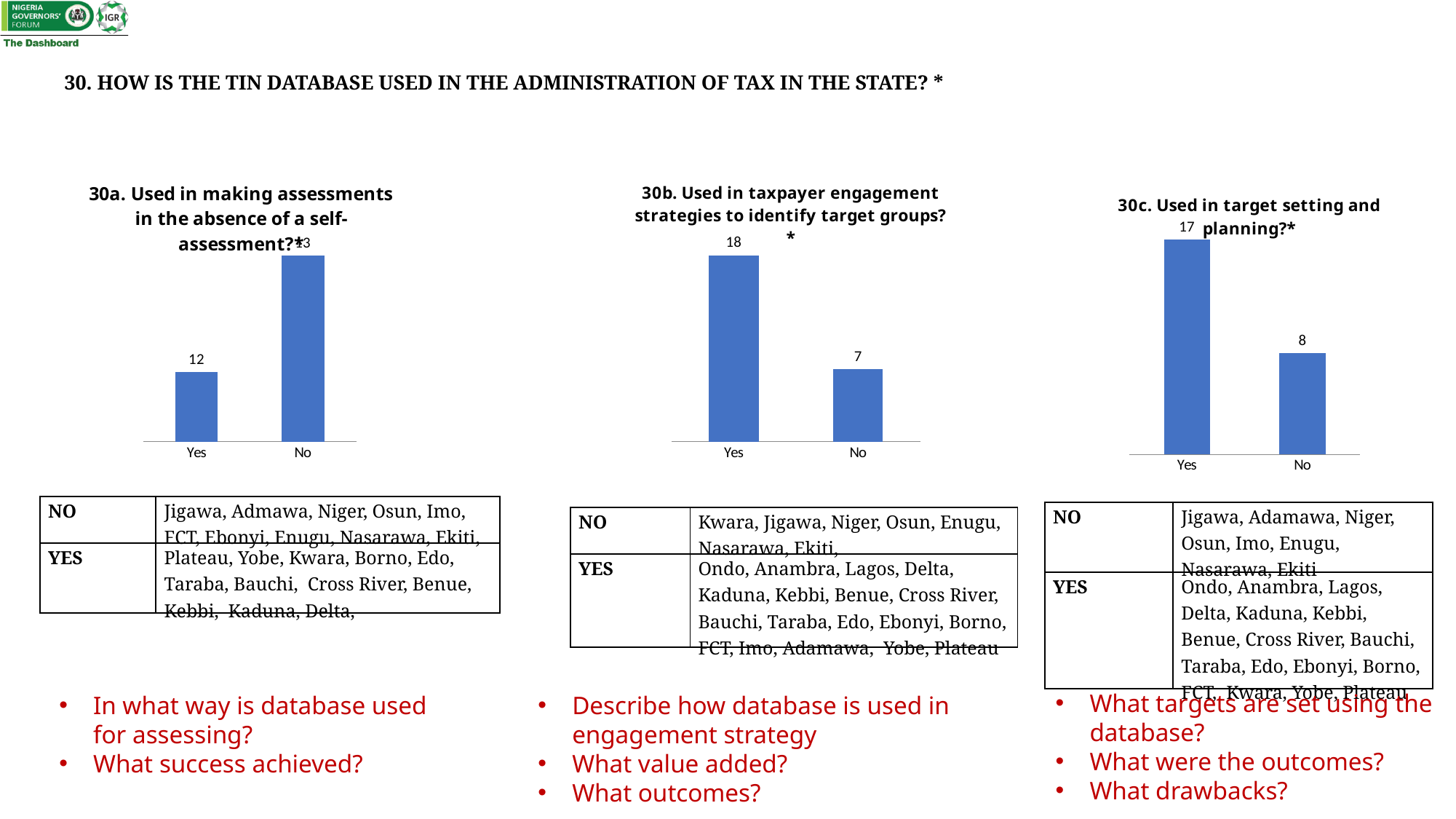
What type of chart is '30b. Used in taxpayer engagement strategies to identify target groups?'? Bar chart In the chart '30c. Used in target setting and planning?', what is the value for Yes? 17 In the chart '30a. Used in making assessments in the absence of a self-assessment?', what is the value for Yes? 12 In the chart '30c. Used in target setting and planning?', what is the difference between the Yes and No values? 9 In the chart '30c. Used in target setting and planning?', which category has the highest value? Yes In the chart '30a. Used in making assessments in the absence of a self-assessment?', how many categories are shown on the x axis? 2 In the chart '30b. Used in taxpayer engagement strategies to identify target groups?', what is the value for No? 7 In the chart '30a. Used in making assessments in the absence of a self-assessment?', what is the value for No? 13 In the chart '30b. Used in taxpayer engagement strategies to identify target groups?', what is the difference between the Yes and No values? 11 In the chart '30b. Used in taxpayer engagement strategies to identify target groups?', what is the value for Yes? 18 In the chart '30b. Used in taxpayer engagement strategies to identify target groups?', which category has the lowest value? No In the chart '30c. Used in target setting and planning?', what is the value for No? 8